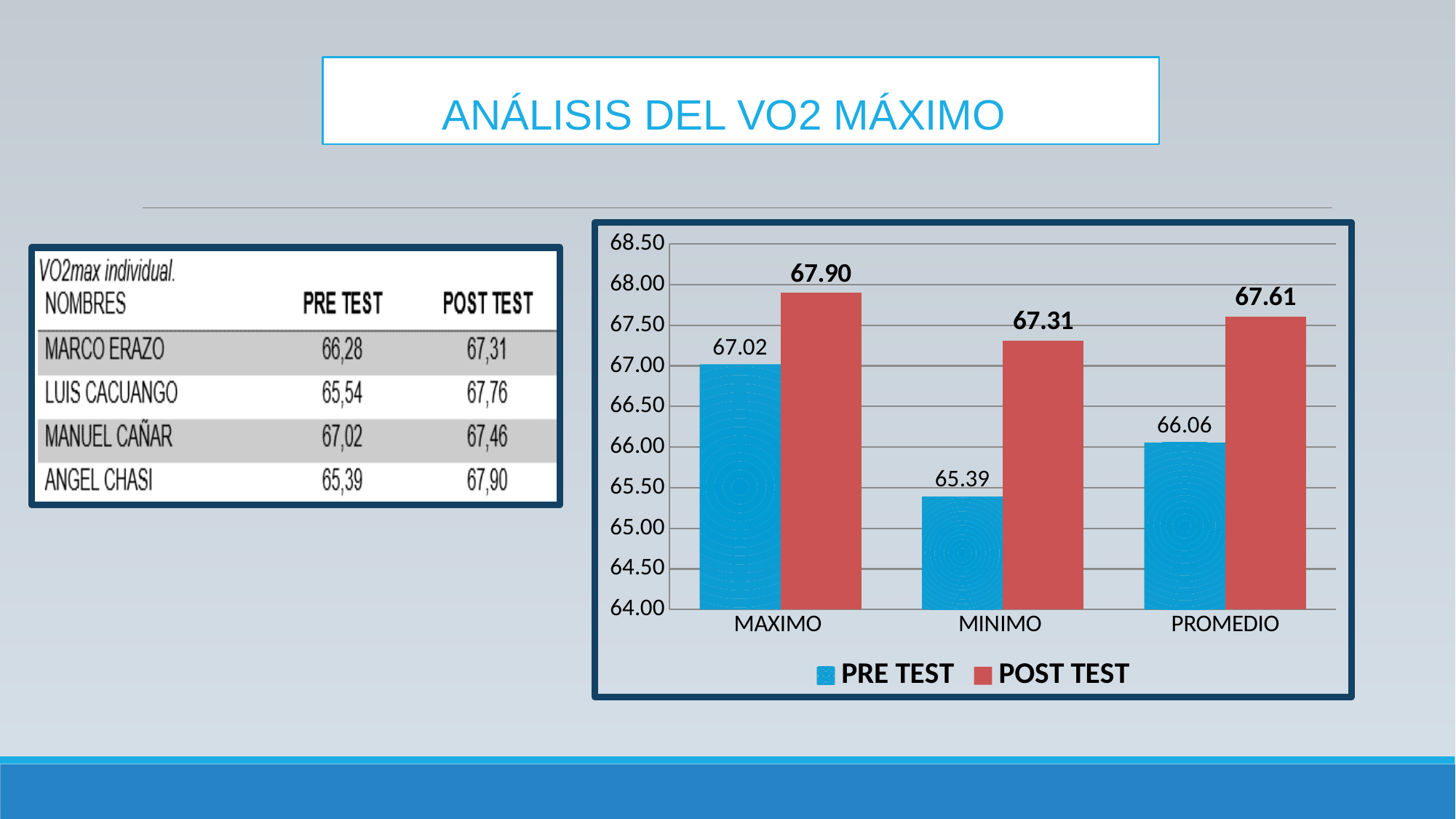
How many series does the chart legend list? 2 Which is larger for PROMEDIO, the PRE TEST value or the POST TEST value? POST TEST What colour are the POST TEST bars in the chart? Red How many categories are shown on the x axis of the chart? 3 What is the difference between the POST TEST and PRE TEST values for MINIMO? 1.92 What is the POST TEST value for MINIMO? 67.31 What is the difference between the POST TEST and PRE TEST values for MAXIMO? 0.88 What kind of chart is shown on the slide? Bar chart What is the POST TEST value for PROMEDIO? 67.61 Which category has the lowest PRE TEST value? MINIMO What is the PRE TEST value for MAXIMO? 67.02 Which category has the highest POST TEST value? MAXIMO